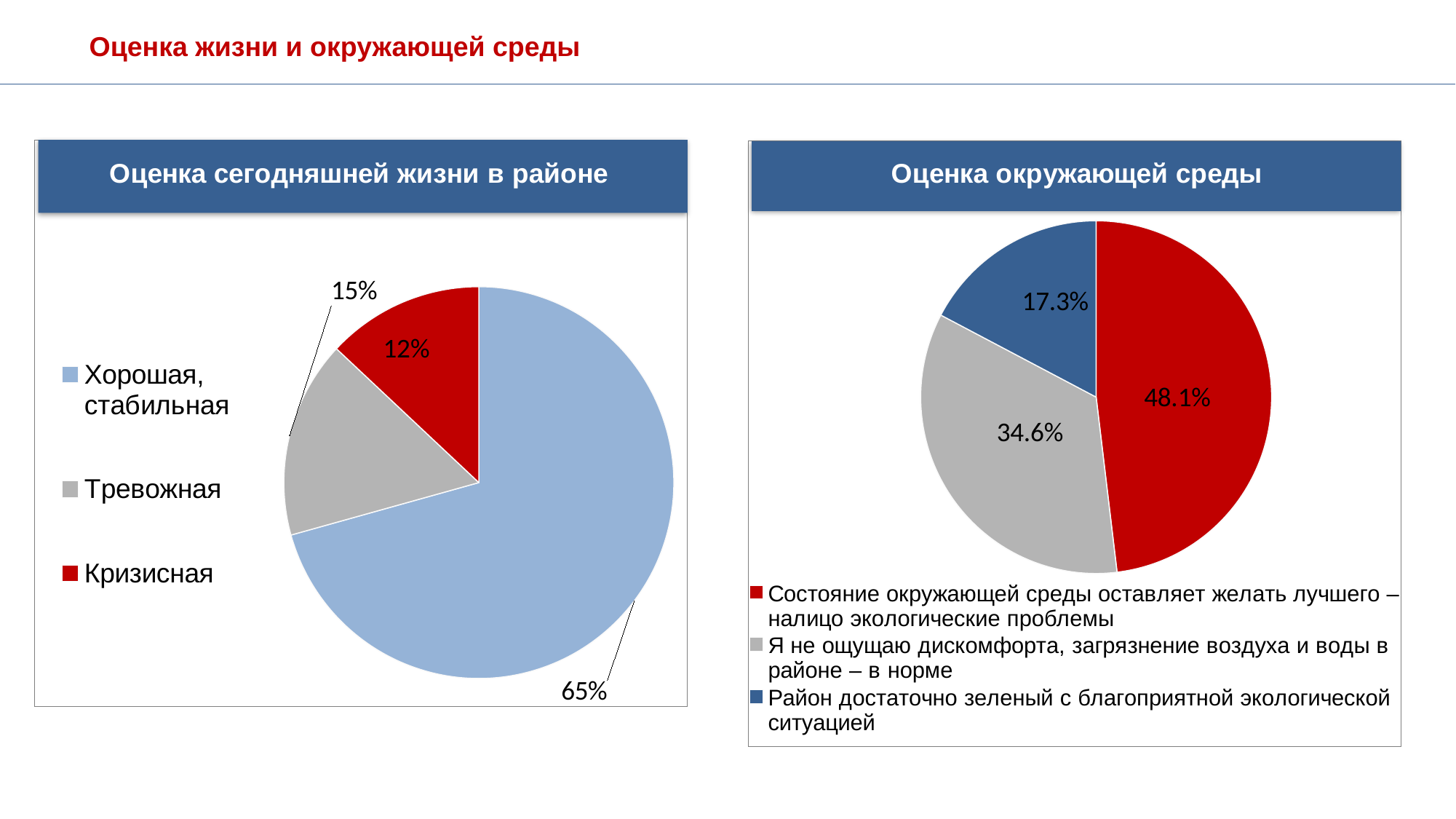
In the chart 'Оценка сегодняшней жизни в районе', what colour is the 'Кризисная' slice? Red In the chart 'Оценка окружающей среды', what percentage is shown for 'Район достаточно зеленый с благоприятной экологической ситуацией'? 17.3% What type of chart is 'Оценка окружающей среды'? Pie chart In the chart 'Оценка сегодняшней жизни в районе', what percentage is shown for 'Кризисная'? 12% In the chart 'Оценка сегодняшней жизни в районе', what is the difference between the 'Тревожная' and 'Кризисная' shares? 3% In the chart 'Оценка сегодняшней жизни в районе', which category has the smallest share? Кризисная In the chart 'Оценка сегодняшней жизни в районе', what percentage is shown for 'Хорошая, стабильная'? 65% How many slices does the chart 'Оценка окружающей среды' have? 3 In the chart 'Оценка сегодняшней жизни в районе', which category has the largest share? Хорошая, стабильная In the chart 'Оценка окружающей среды', what is the difference between the largest slice (48.1%) and the smallest slice (17.3%)? 30.8% In the chart 'Оценка окружающей среды', which category has the largest share? Состояние окружающей среды оставляет желать лучшего – налицо экологические проблемы In the chart 'Оценка окружающей среды', what percentage is shown for 'Я не ощущаю дискомфорта, загрязнение воздуха и воды в районе – в норме'? 34.6%